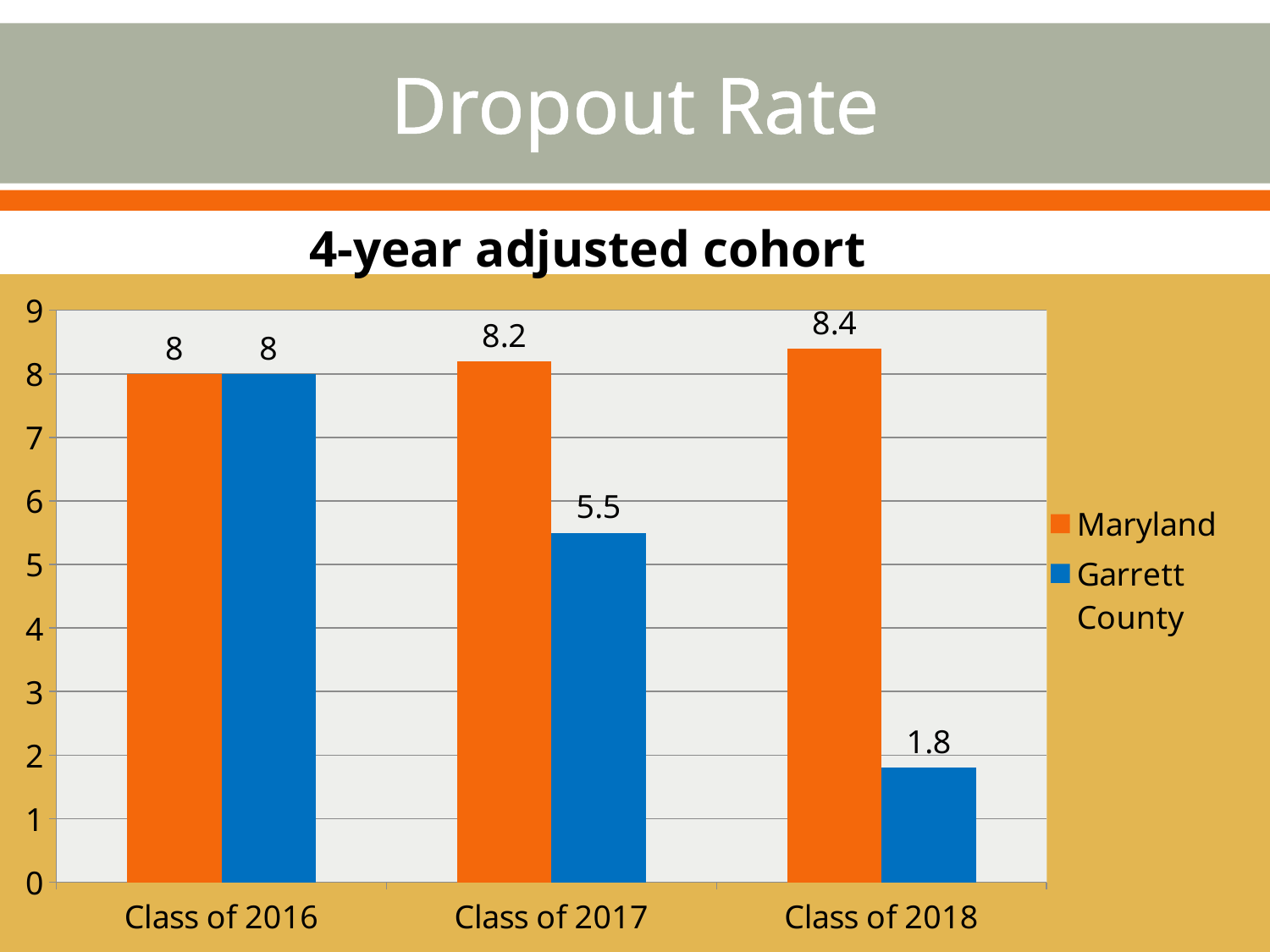
What is the difference between the Maryland and Garrett County dropout rates for the Class of 2018? 6.6 Which class year has the lowest Garrett County dropout rate? Class of 2018 For the Class of 2017, which is larger, the Maryland rate or the Garrett County rate? Maryland What is the difference between the Maryland and Garrett County dropout rates for the Class of 2017? 2.7 What is the Maryland dropout rate for the Class of 2017? 8.2 What is the Garrett County dropout rate for the Class of 2016? 8 How many series does the legend list? 2 Which class year has the highest Maryland dropout rate? Class of 2018 Does the Garrett County dropout rate rise or fall from the Class of 2016 to the Class of 2018? Fall How many class years are shown on the x axis? 3 What kind of chart is shown on the slide? Bar chart What is the Garrett County dropout rate for the Class of 2018? 1.8